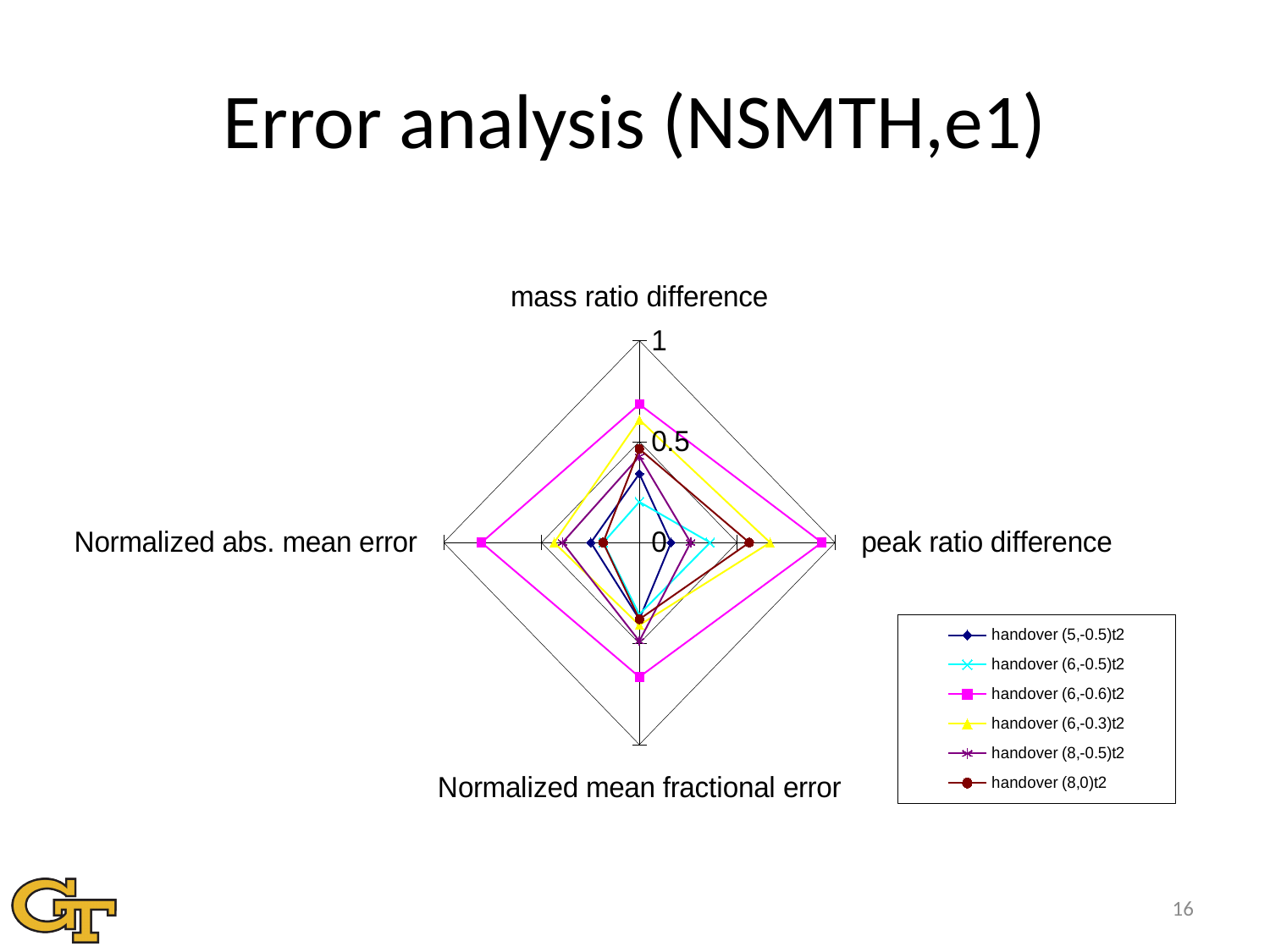
Is the value of handover (6,-0.6)t2 on the mass ratio difference axis greater or less than 0.5? greater Which series has the largest values on all four axes of the radar chart? handover (6,-0.6)t2 Is the value of handover (6,-0.5)t2 on the mass ratio difference axis greater or less than 0.5? less How many series does the legend list? 6 What kind of chart is shown on the slide? Radar chart Is the value of handover (5,-0.5)t2 on the peak ratio difference axis greater or less than 0.5? less On the peak ratio difference axis, which is larger: handover (6,-0.6)t2 or handover (5,-0.5)t2? handover (6,-0.6)t2 How many axes (categories) does the radar chart have? 4 Which series has the lowest value on the mass ratio difference axis? handover (6,-0.5)t2 What is the title of the slide containing the radar chart? Error analysis (NSMTH,e1)